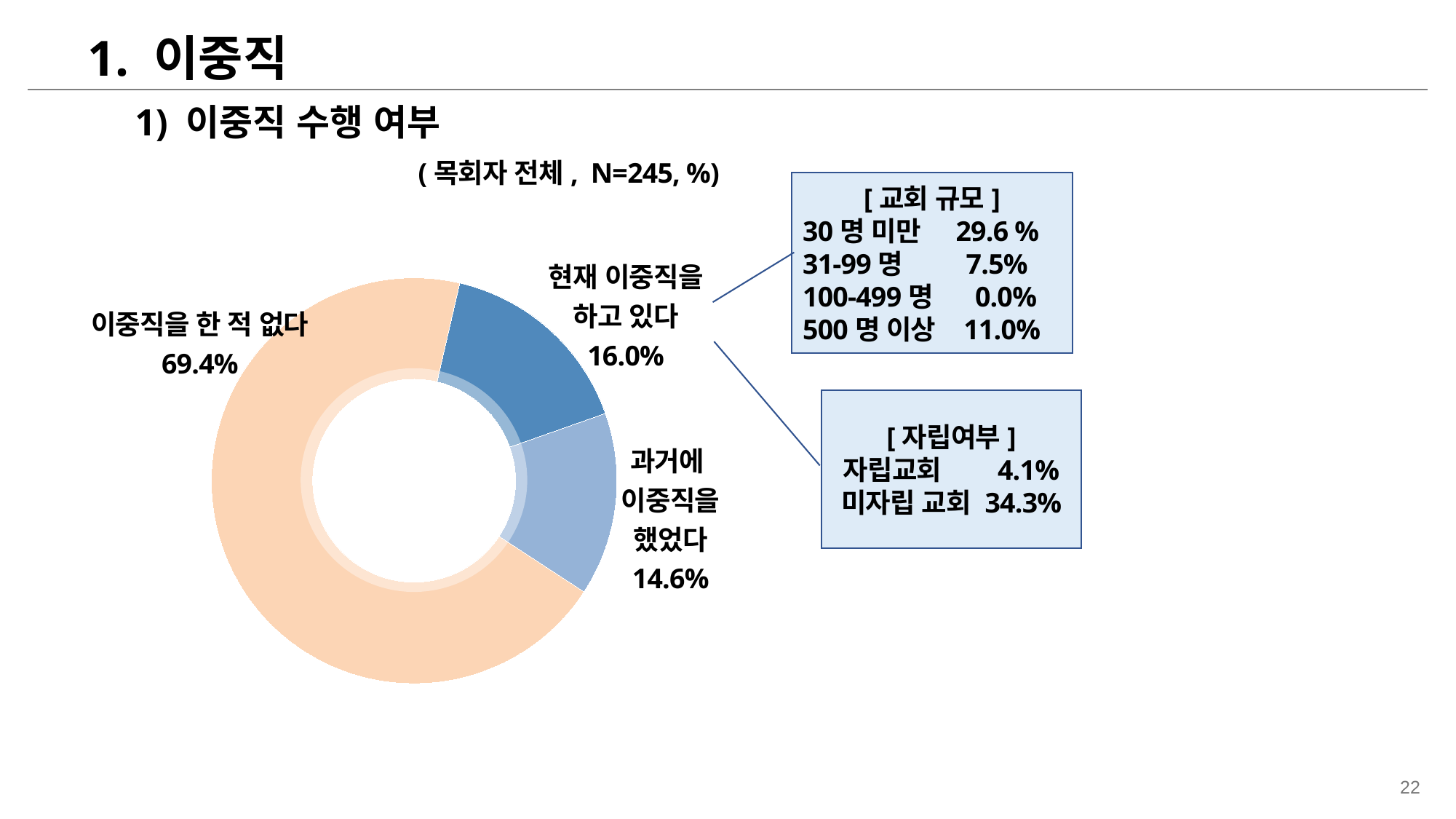
In the 교회 규모 box, what is the value for 30 명 미만? 29.6 % What kind of chart is shown on the slide? Donut (pie) chart Which is larger, the share for 현재 이중직을 하고 있다 or the share for 과거에 이중직을 했었다? 현재 이중직을 하고 있다 What percentage of respondents answered 현재 이중직을 하고 있다? 16.0% What is the difference in percentage points between 이중직을 한 적 없다 and 현재 이중직을 하고 있다? 53.4 Which category has the largest share of the donut chart? 이중직을 한 적 없다 What percentage of respondents answered 이중직을 한 적 없다? 69.4% What percentage of respondents answered 과거에 이중직을 했었다? 14.6% Which category has the smallest share of the donut chart? 과거에 이중직을 했었다 What is the sample size (N) stated above the chart? 245 What is the difference in percentage points between 현재 이중직을 하고 있다 and 과거에 이중직을 했었다? 1.4 How many categories are shown in the donut chart? 3